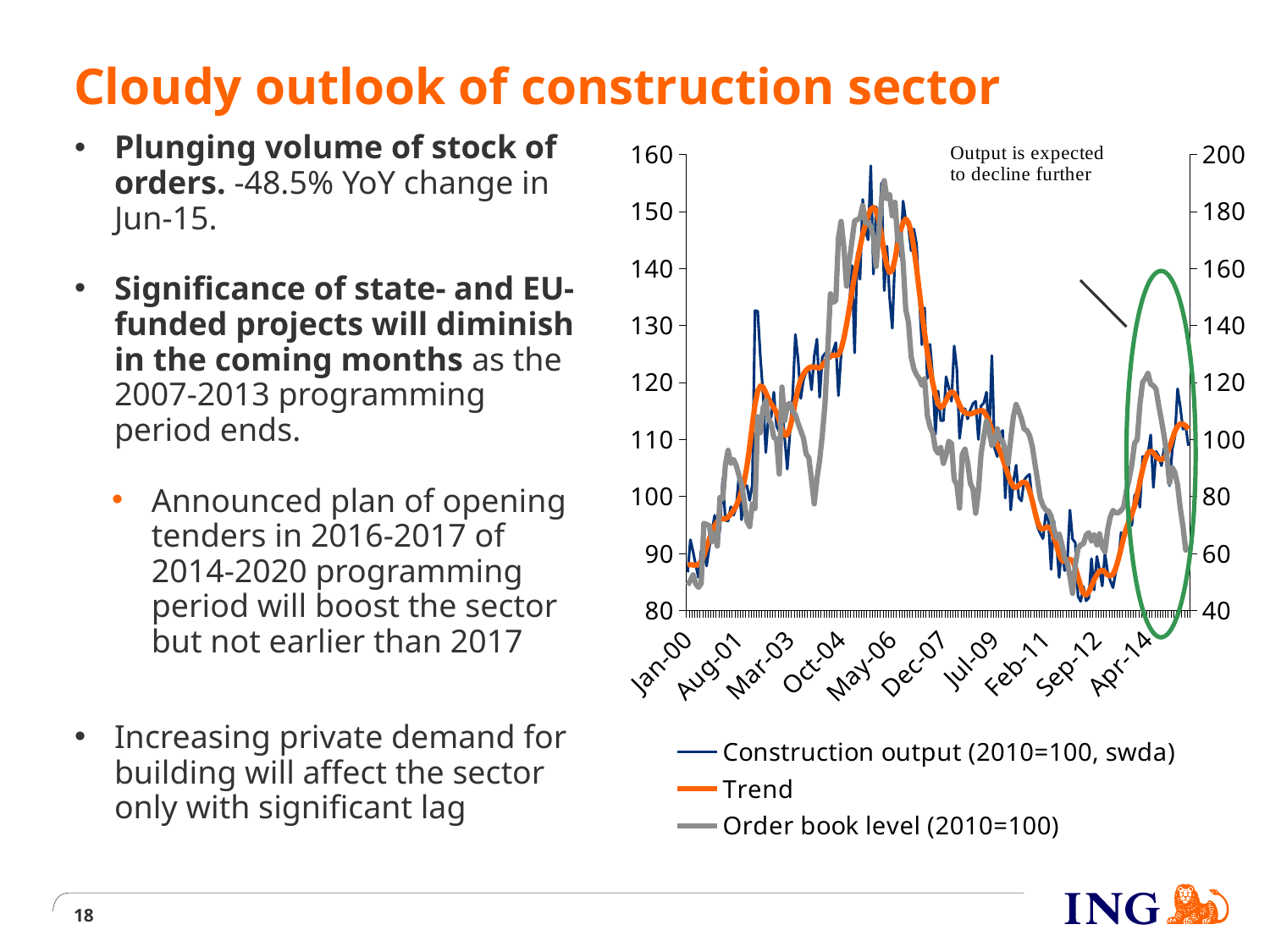
Is the Trend value around Sep-12 greater or less than 100 on the left axis? less How many series does the chart legend list? 3 Which series in the chart is drawn in orange? Trend What does the annotation text inside the chart say? Output is expected to decline further Is the Order book level at the far right end of the chart greater or less than 80 on the right axis? less What kind of chart is shown on the slide? Line chart Is the peak value of the Construction output series around May-06 greater or less than 140 on the left axis? greater What is the highest value shown on the right-hand y axis of the chart? 200 Does the Construction output series rise or fall between May-06 and Sep-12? fall Does the Trend series rise or fall between Jan-00 and May-06? rise How many date labels are shown on the x axis of the chart? 10